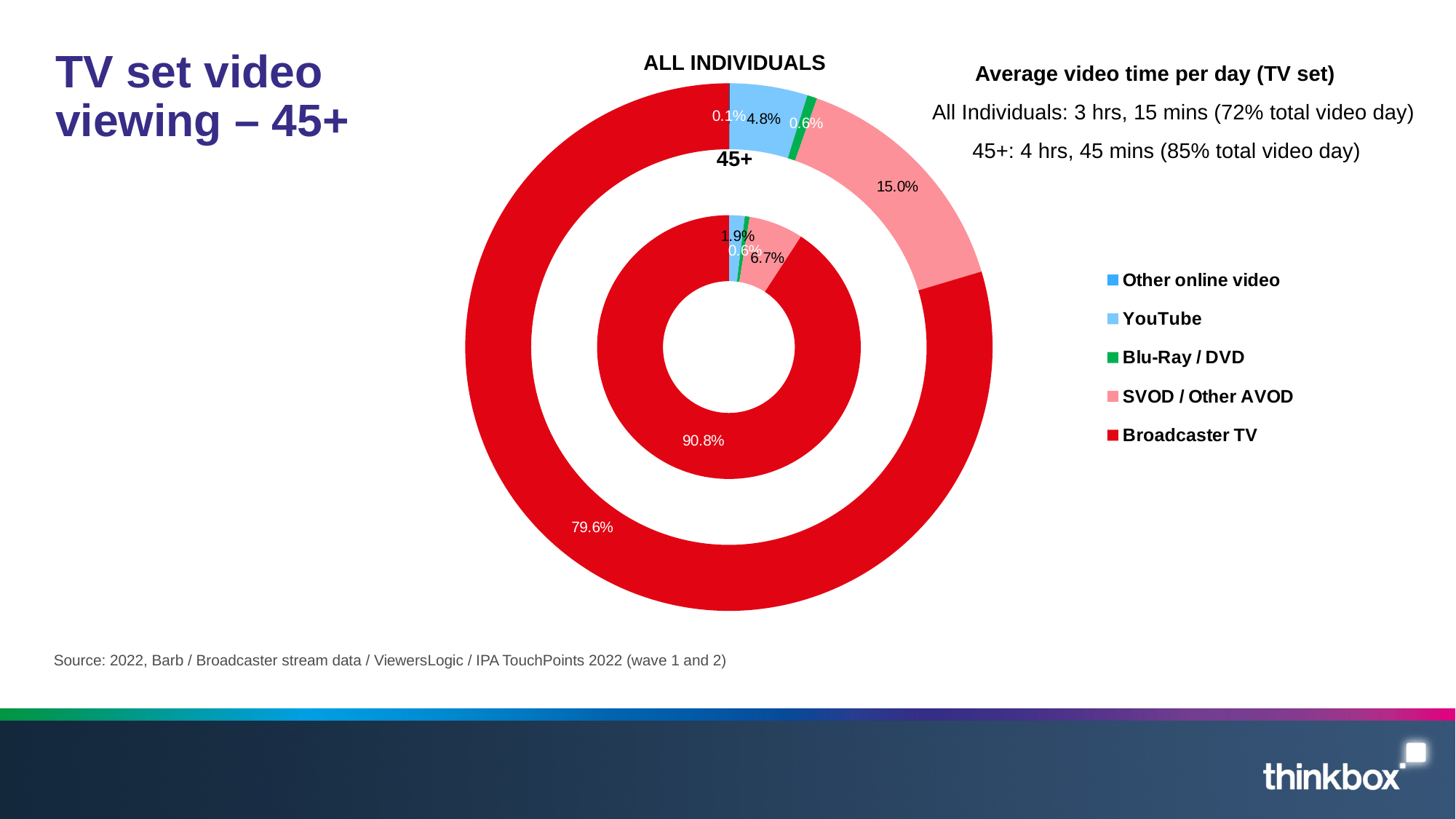
In the 45+ ring, what share does Broadcaster TV have? 90.8% Is the SVOD / Other AVOD share larger for ALL INDIVIDUALS or for 45+? ALL INDIVIDUALS In the ALL INDIVIDUALS ring, what share does YouTube have? 4.8% In the 45+ ring, what share does YouTube have? 1.9% In the ALL INDIVIDUALS ring, what share does Broadcaster TV have? 79.6% In the ALL INDIVIDUALS ring, what share does SVOD / Other AVOD have? 15.0% Which category has the largest share in the 45+ ring? Broadcaster TV What is the difference between the Broadcaster TV share for 45+ and for ALL INDIVIDUALS? 11.2 percentage points In the 45+ ring, what share does SVOD / Other AVOD have? 6.7% What type of chart is shown on the slide? Doughnut chart How many categories does the legend list? 5 In the ALL INDIVIDUALS ring, what share does Other online video have? 0.1%